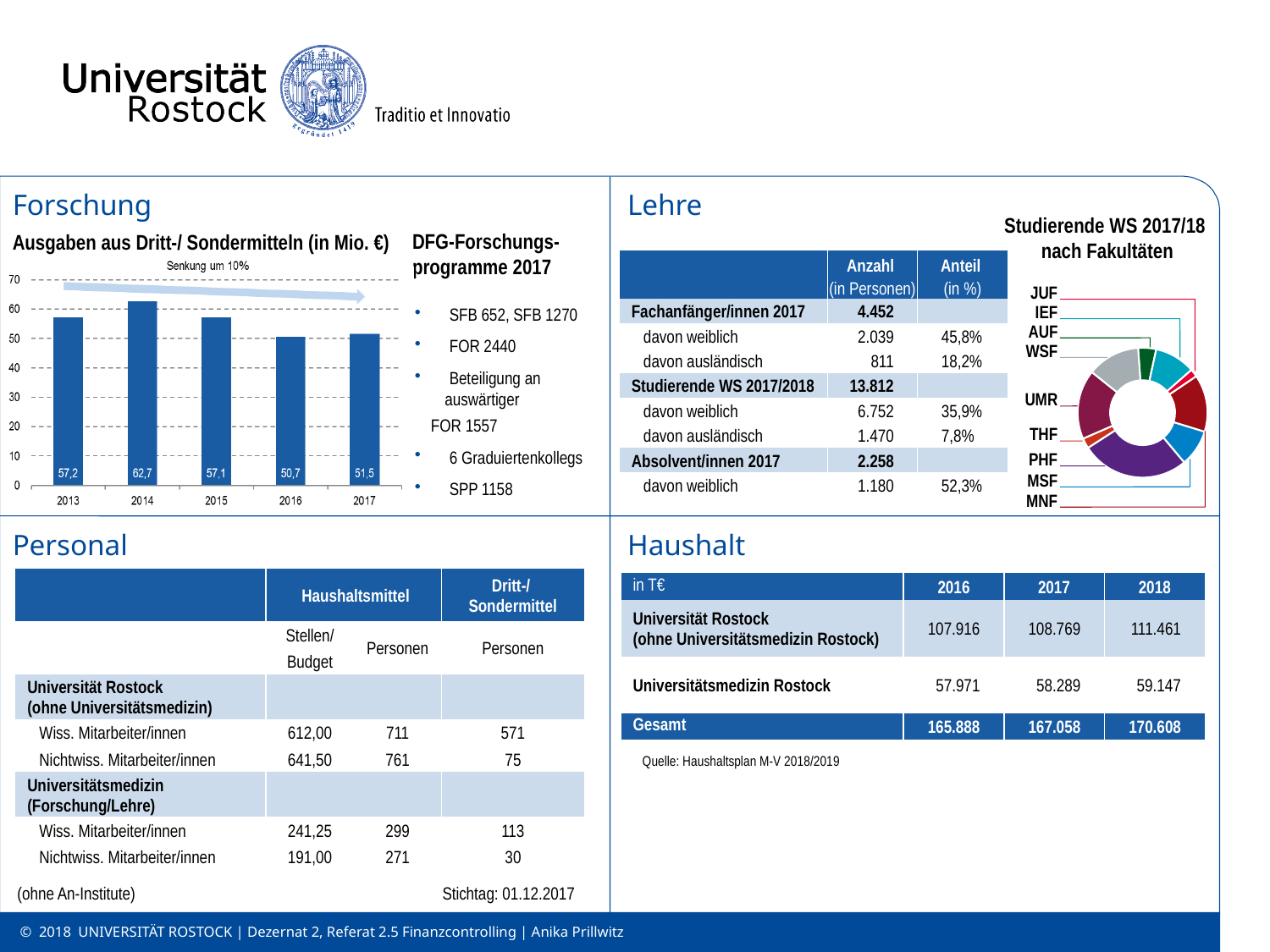
In the bar chart 'Ausgaben aus Dritt-/ Sondermitteln (in Mio. €)', what is the value for 2014? 62,7 In the bar chart 'Ausgaben aus Dritt-/ Sondermitteln (in Mio. €)', which year has the highest value? 2014 How many years are shown in the bar chart 'Ausgaben aus Dritt-/ Sondermitteln (in Mio. €)'? 5 In the bar chart 'Ausgaben aus Dritt-/ Sondermitteln (in Mio. €)', which is larger, the value for 2013 or the value for 2015? 2013 In the bar chart 'Ausgaben aus Dritt-/ Sondermitteln (in Mio. €)', what is the value for 2017? 51,5 What kind of chart is 'Ausgaben aus Dritt-/ Sondermitteln (in Mio. €)'? bar chart In the bar chart 'Ausgaben aus Dritt-/ Sondermitteln (in Mio. €)', do the values rise or fall from 2014 to 2016? fall How many faculties are labelled in the chart 'Studierende WS 2017/18 nach Fakultäten'? 9 In the bar chart 'Ausgaben aus Dritt-/ Sondermitteln (in Mio. €)', what is the difference between the values for 2014 and 2016? 12,0 In the bar chart 'Ausgaben aus Dritt-/ Sondermitteln (in Mio. €)', is the value for 2014 greater or less than 60? greater In the bar chart 'Ausgaben aus Dritt-/ Sondermitteln (in Mio. €)', which year has the lowest value? 2016 What kind of chart is 'Studierende WS 2017/18 nach Fakultäten'? doughnut chart